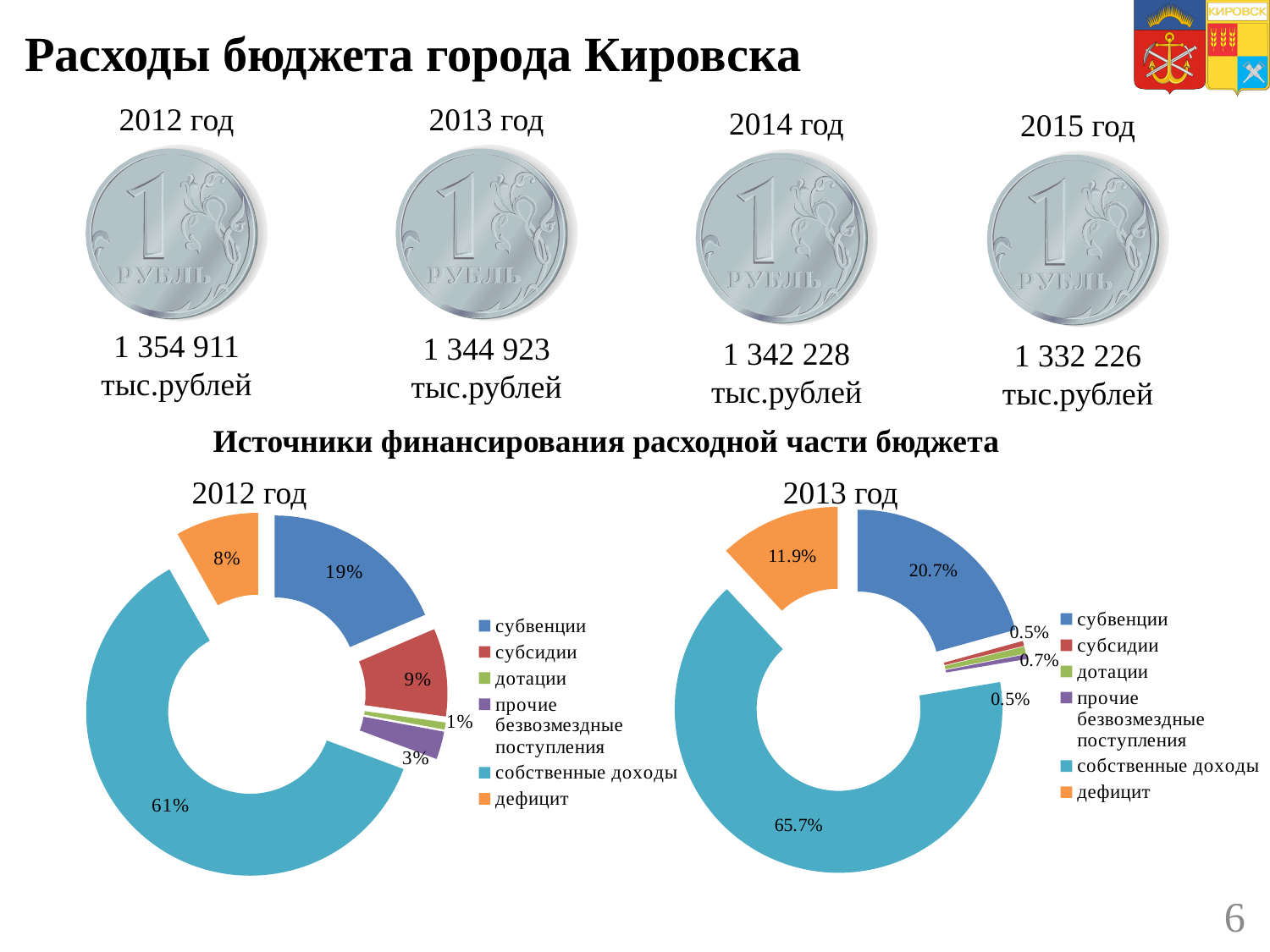
In the 2012 год chart, which category has the smallest share? дотации In the 2013 год chart, which is larger, субвенции or дефицит? субвенции In the 2012 год chart, what share is дефицит? 8% In the 2013 год chart, what share is субвенции? 20.7% In the 2012 год chart, what share is собственные доходы? 61% What kind of chart is the 2012 год chart? doughnut chart How many categories does the legend of the 2013 год chart list? 6 In the 2013 год chart, what share is собственные доходы? 65.7% In the 2012 год chart, which category has the largest share? собственные доходы In the 2012 год chart, what is the difference between субвенции and субсидии? 10% In the 2013 год chart, what share is дефицит? 11.9% In the 2012 год chart, what share is субвенции? 19%